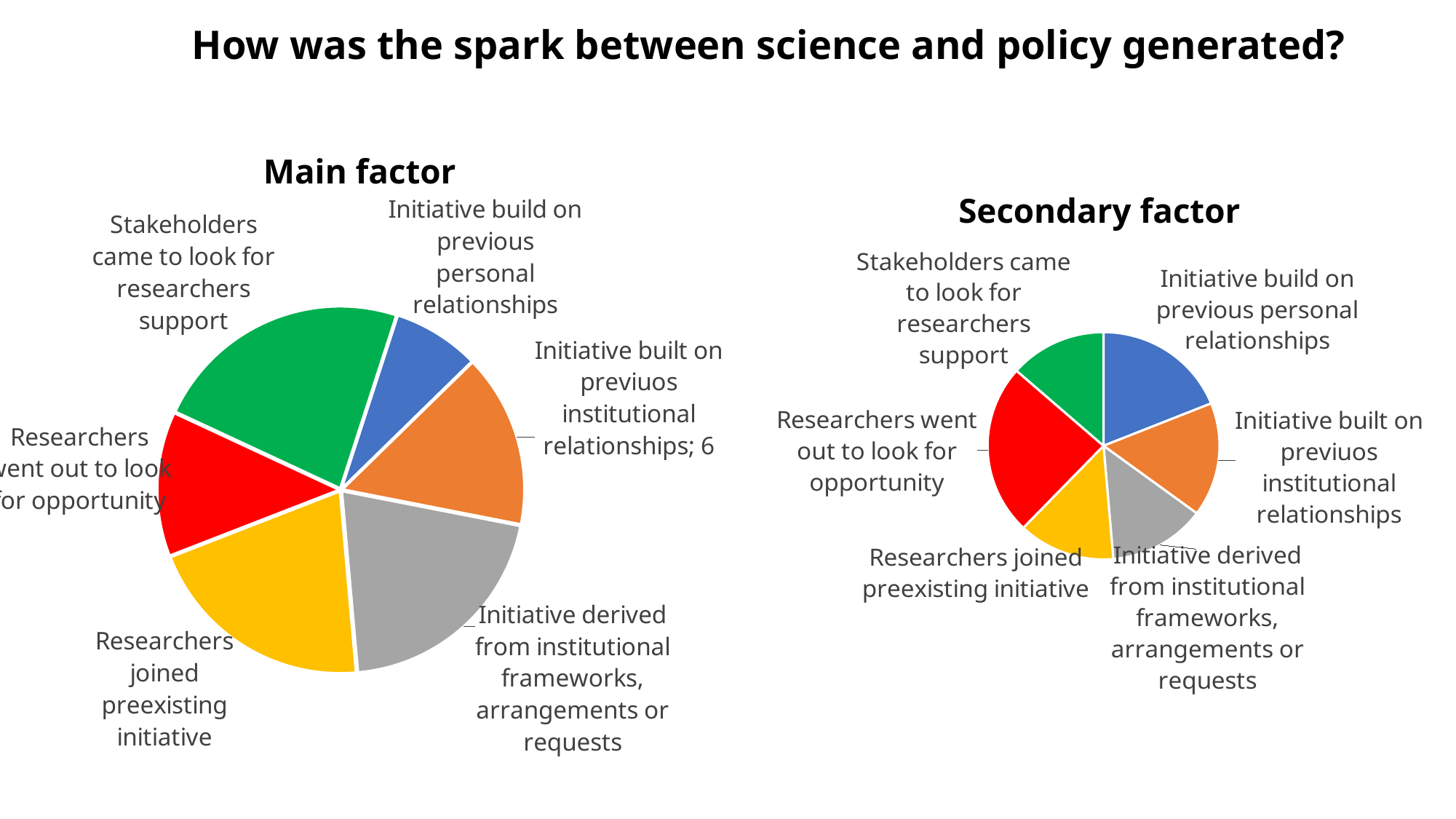
In the "Secondary factor" chart, what colour is the slice for "Researchers went out to look for opportunity"? Red How many slices does the "Main factor" pie chart have? 6 What is the title of the slide? How was the spark between science and policy generated? How many slices does the "Secondary factor" pie chart have? 6 In the "Main factor" chart, which category has the smallest slice? Initiative build on previous personal relationships In the "Main factor" chart, what value is shown for "Initiative built on previuos institutional relationships"? 6 What kind of chart is the "Secondary factor" chart? Pie chart In the "Main factor" chart, which slice is larger: "Stakeholders came to look for researchers support" or "Initiative build on previous personal relationships"? Stakeholders came to look for researchers support In the "Main factor" chart, which slice is larger: "Researchers joined preexisting initiative" or "Researchers went out to look for opportunity"? Researchers joined preexisting initiative In the "Secondary factor" chart, which category has the largest slice? Researchers went out to look for opportunity What kind of chart is the "Main factor" chart? Pie chart In the "Secondary factor" chart, which slice is larger: "Researchers went out to look for opportunity" or "Researchers joined preexisting initiative"? Researchers went out to look for opportunity